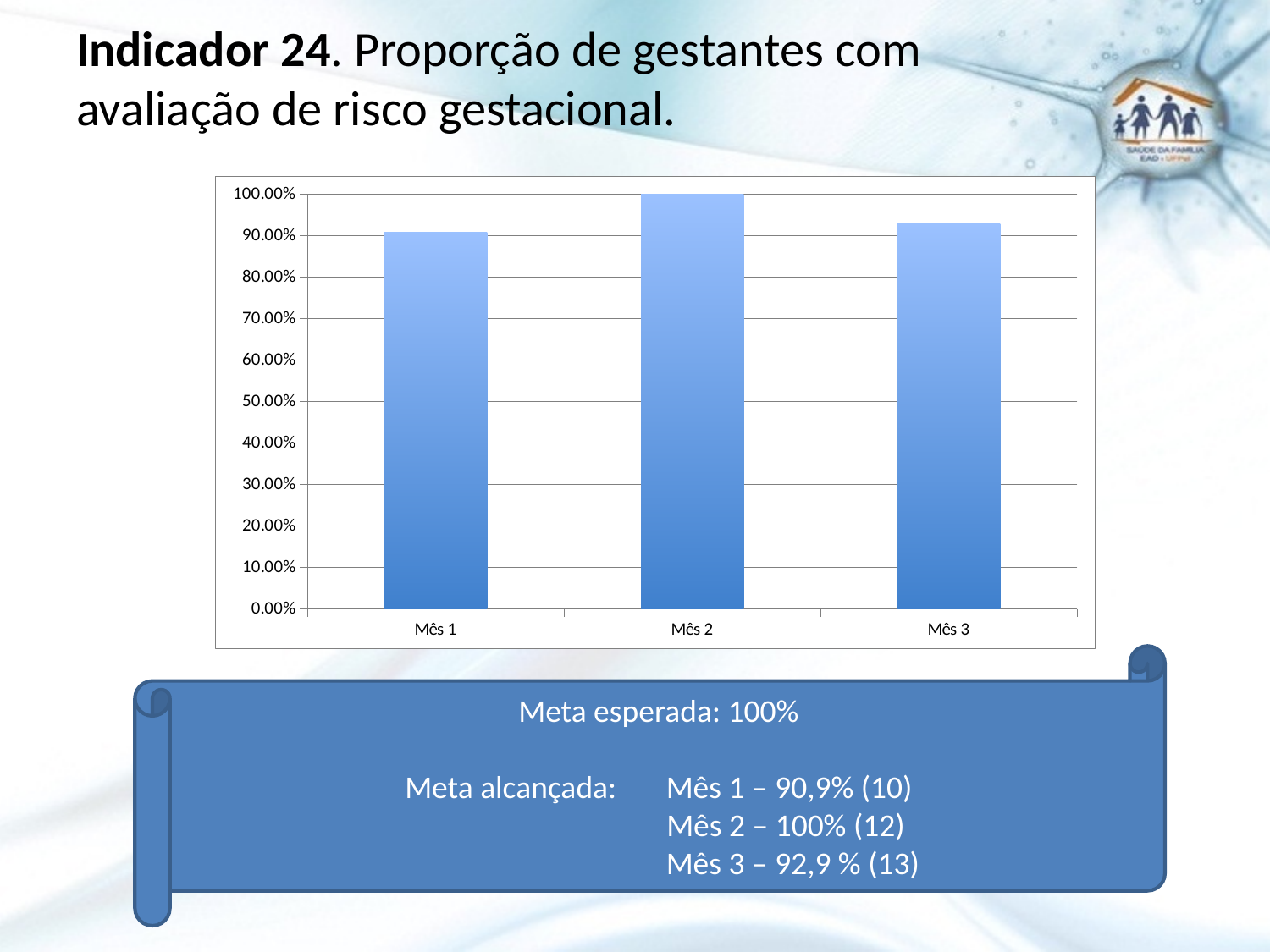
Which month has the highest bar in the chart? Mês 2 Which is larger, the value for Mês 2 or the value for Mês 1? Mês 2 Is the value for Mês 1 greater or less than 90.00%? greater What kind of chart is shown on the slide? Bar chart Is the value for Mês 3 greater or less than 100.00%? less According to the slide, what proportion was reached in Mês 1? 90,9% How many categories (months) are plotted on the chart? 3 Do the values rise or fall from Mês 1 to Mês 2? Rise What is the value for Mês 2 in the chart? 100% Which month has the lowest bar in the chart? Mês 1 What is the highest value shown on the vertical axis of the chart? 100.00% According to the slide, what proportion was reached in Mês 3? 92,9 %